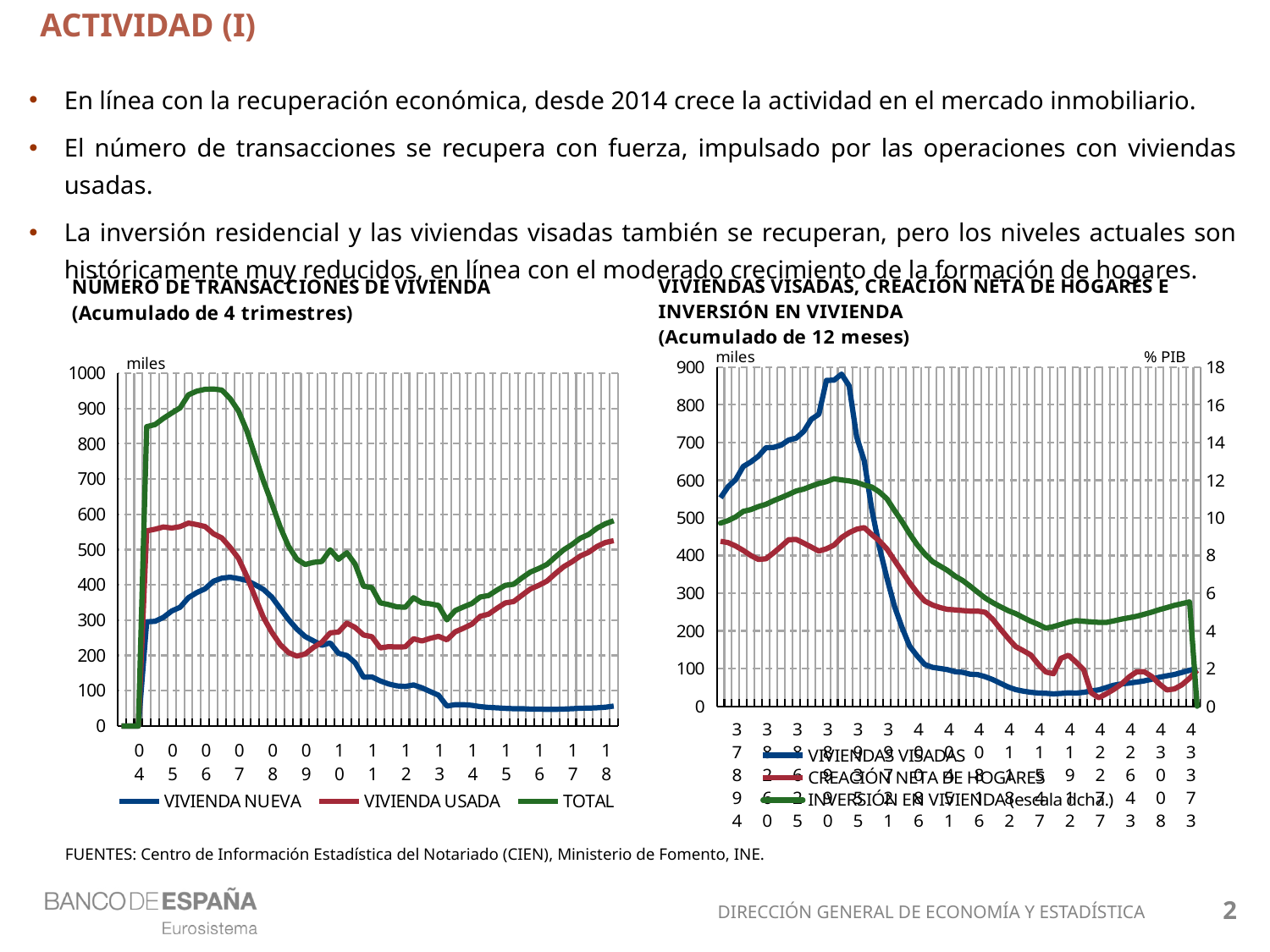
How many series does the legend of the left chart, 'NÚMERO DE TRANSACCIONES DE VIVIENDA', list? 3 In the right chart, 'VIVIENDAS VISADAS, CREACIÓN NETA DE HOGARES E INVERSIÓN EN VIVIENDA', is the peak value of VIVIENDAS VISADAS greater or less than 800? greater In the right chart, 'VIVIENDAS VISADAS, CREACIÓN NETA DE HOGARES E INVERSIÓN EN VIVIENDA', is the value of VIVIENDAS VISADAS at the end of the period greater or less than 200? less What unit is shown on the right-hand axis of the right chart, 'VIVIENDAS VISADAS, CREACIÓN NETA DE HOGARES E INVERSIÓN EN VIVIENDA'? % PIB How many series does the legend of the right chart, 'VIVIENDAS VISADAS, CREACIÓN NETA DE HOGARES E INVERSIÓN EN VIVIENDA', list? 3 In the left chart, 'NÚMERO DE TRANSACCIONES DE VIVIENDA', which series is higher at the end of the period: VIVIENDA NUEVA or VIVIENDA USADA? VIVIENDA USADA In the left chart, 'NÚMERO DE TRANSACCIONES DE VIVIENDA', is the value of VIVIENDA NUEVA at the end of the period (2018) greater or less than 100? less In the left chart, 'NÚMERO DE TRANSACCIONES DE VIVIENDA', does the VIVIENDA NUEVA series rise or fall between 2007 and 2013? Fall In the right chart, 'VIVIENDAS VISADAS, CREACIÓN NETA DE HOGARES E INVERSIÓN EN VIVIENDA', which series is plotted on the right-hand axis? INVERSIÓN EN VIVIENDA What kind of chart is the left chart, 'NÚMERO DE TRANSACCIONES DE VIVIENDA'? Line chart In the left chart, 'NÚMERO DE TRANSACCIONES DE VIVIENDA', does the TOTAL series rise or fall between 2014 and 2018? Rise